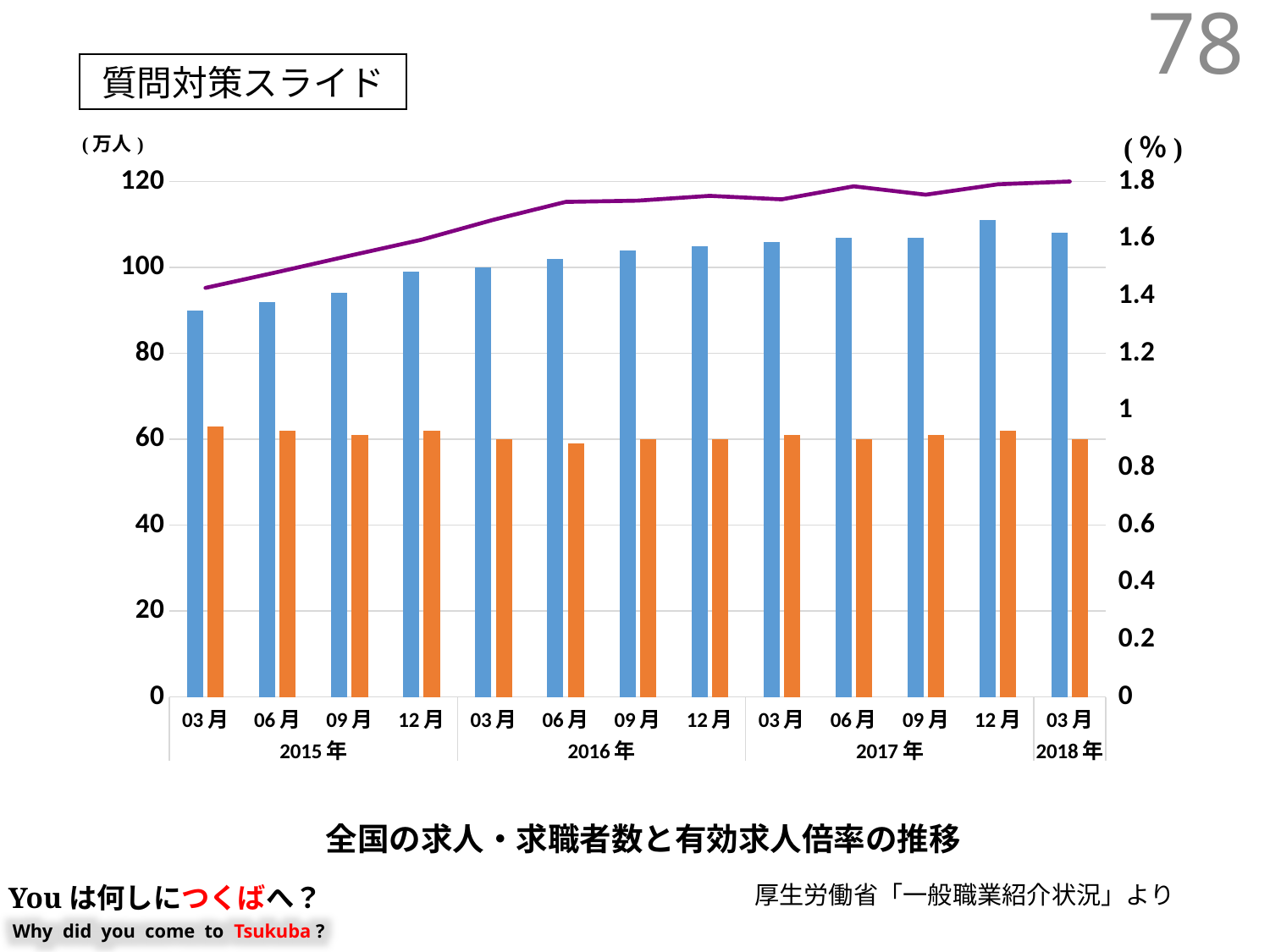
At which time point is the blue bar lowest? 03月 2015年 Is the blue bar for 12月 2017 greater or less than 100? greater Is the blue bar for 03月 2015 greater or less than 100? less Is the orange bar for 06月 2016 greater or less than 80? less How many time points (months) are shown along the x axis? 13 What kind of chart is shown on the slide? bar chart with a line Do the blue bars generally rise or fall from 2015 to 2018? rise Which is larger, the blue bar for 03月 2015 or the blue bar for 03月 2018? 03月 2018 What is the title printed below the chart? 全国の求人・求職者数と有効求人倍率の推移 What unit is shown for the left vertical axis? 万人